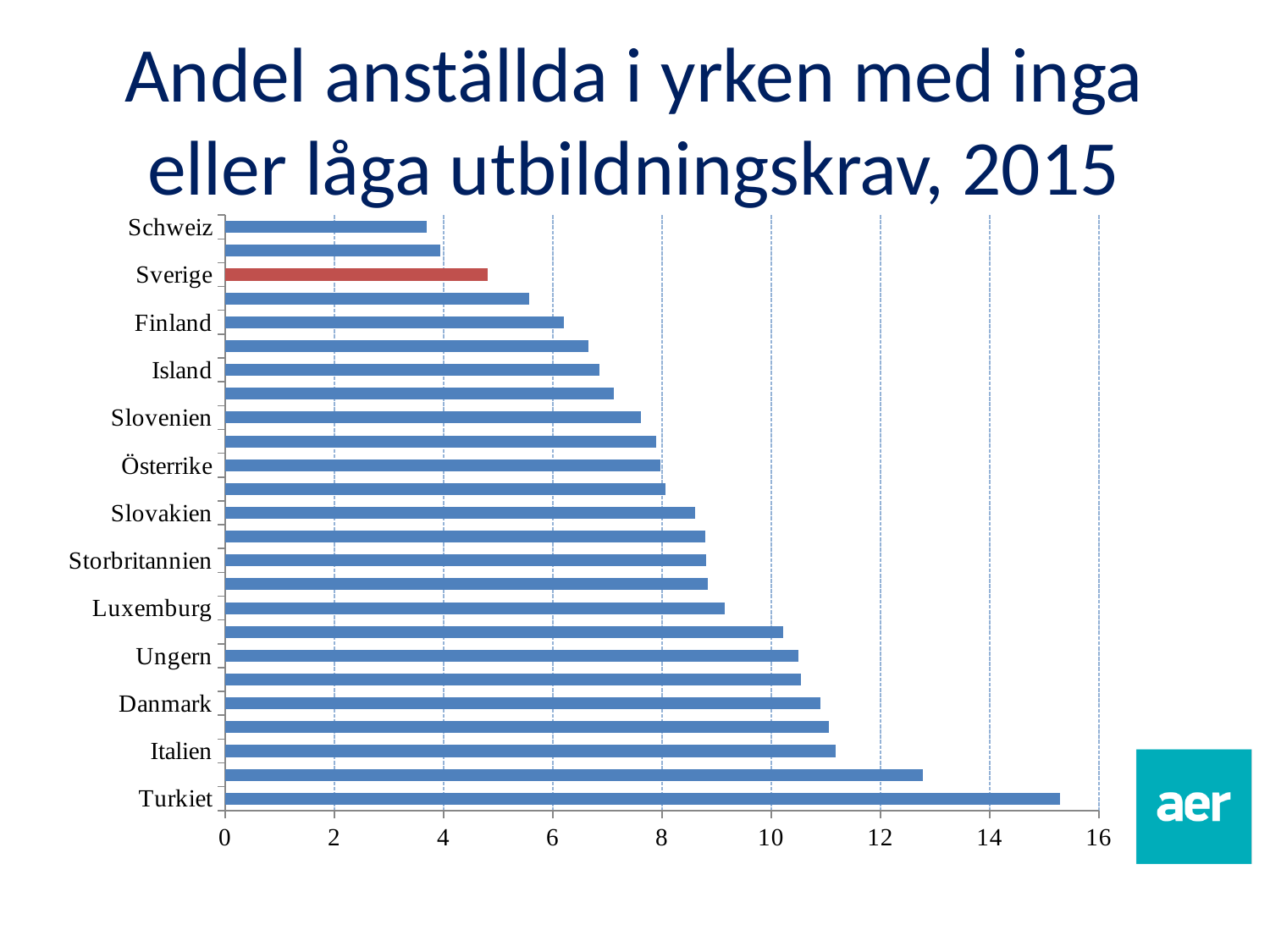
Which country has the lowest value in the chart? Schweiz Is the value for Turkiet greater or less than 14? greater What kind of chart is shown on the slide? bar chart Is the value for Sverige greater or less than 4? greater Is the value for Slovenien greater or less than 8? less Which has the larger value, Danmark or Sverige? Danmark Which country has the highest value in the chart? Turkiet What is the title of the chart? Andel anställda i yrken med inga eller låga utbildningskrav, 2015 Which bar is highlighted in a different colour (red) from the others? Sverige